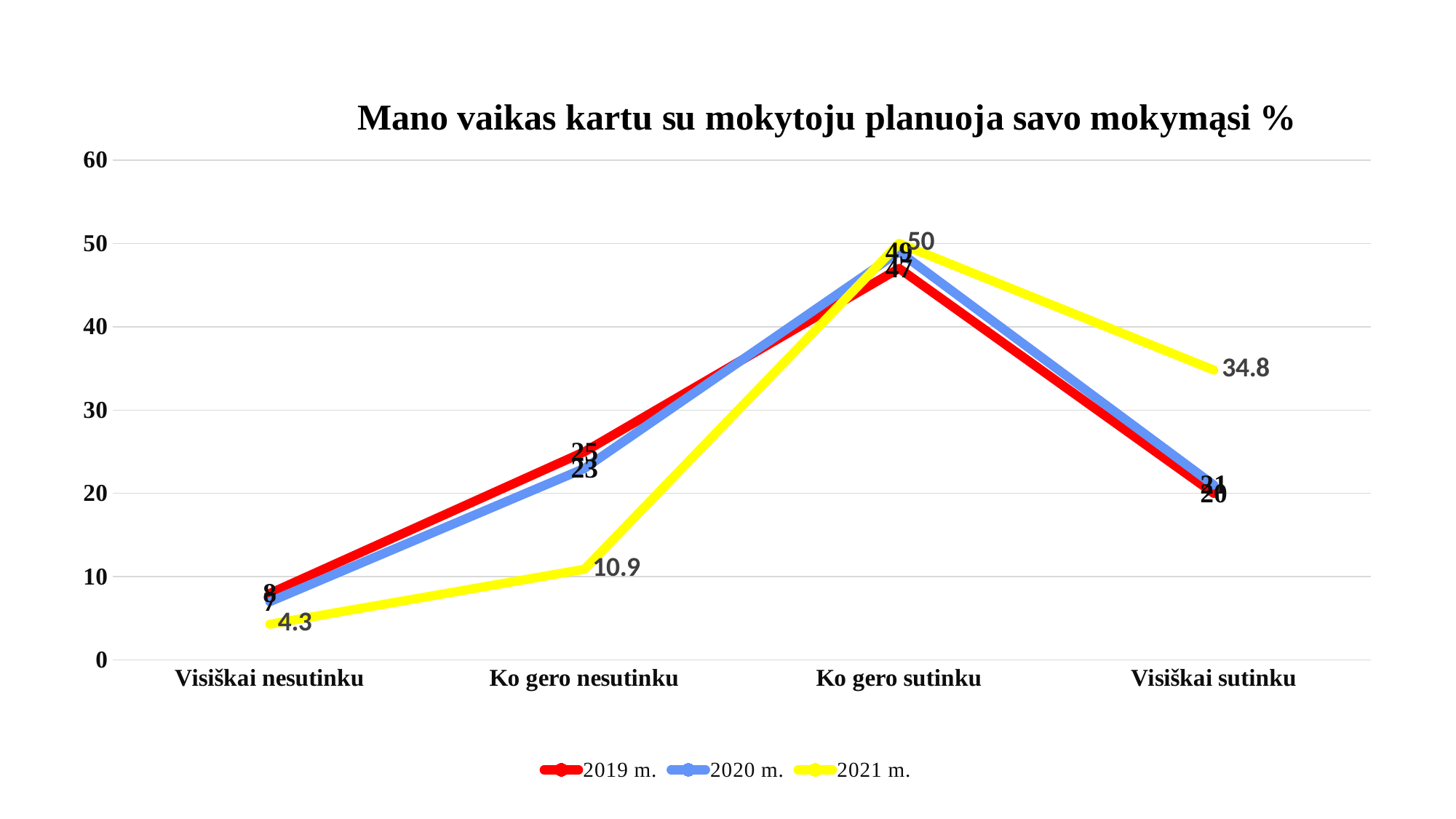
What is the difference between the 2021 m. values at Ko gero sutinku and Visiškai sutinku? 15.2 What is the value for 2021 m. at Visiškai sutinku? 34.8 What is the value for 2021 m. at Ko gero sutinku? 50 For the 2021 m. series, which category has the lowest value? Visiškai nesutinku How many categories are shown on the x axis? 4 How many series does the legend list? 3 What is the value for 2021 m. at Ko gero nesutinku? 10.9 What kind of chart is shown on the slide? line chart Is the value for 2019 m. at Ko gero sutinku greater or less than 40? greater At Visiškai sutinku, which series has the larger value, 2019 m. or 2021 m.? 2021 m. For the 2021 m. series, which category has the highest value? Ko gero sutinku What is the value for 2021 m. at Visiškai nesutinku? 4.3